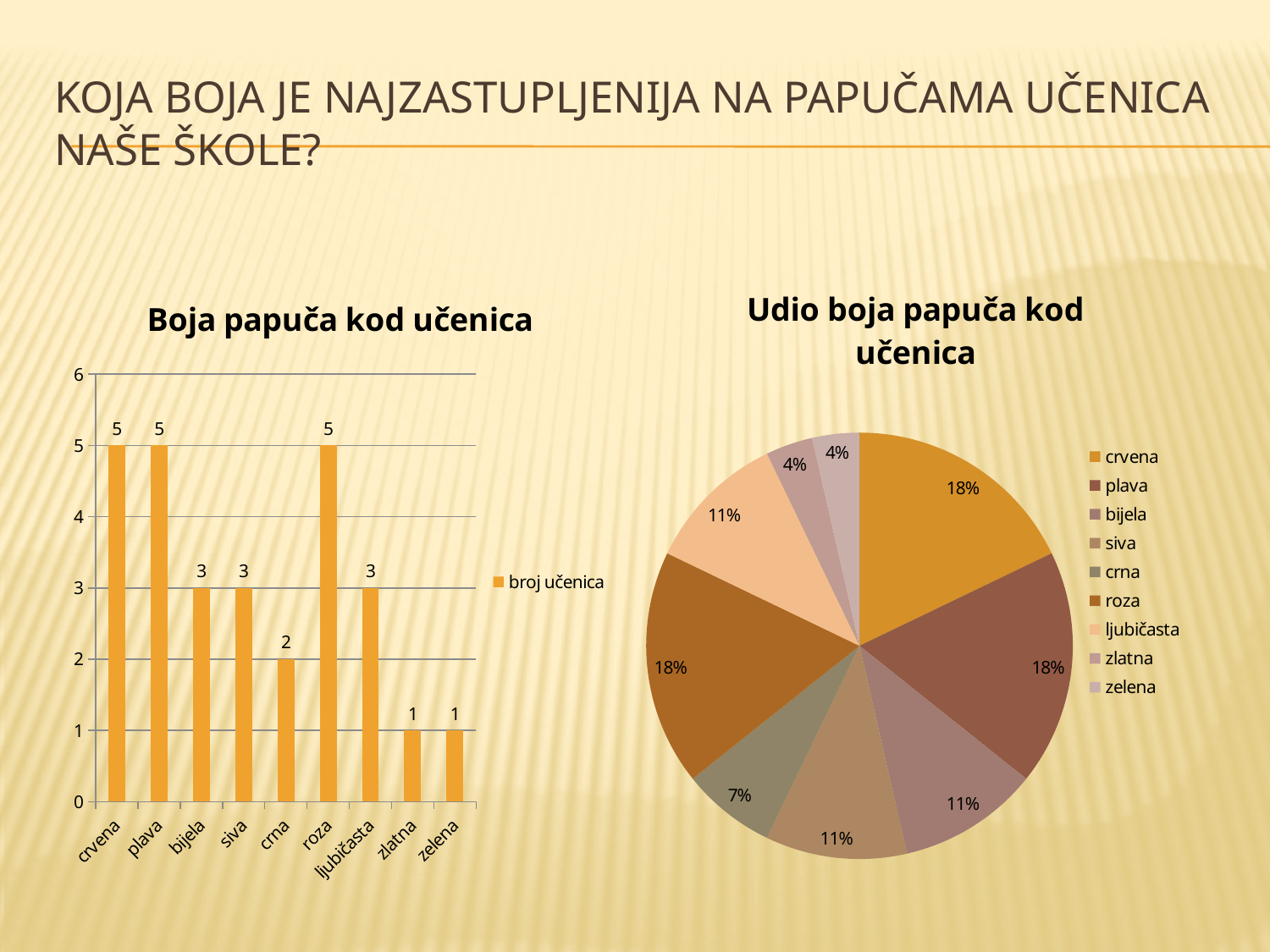
In the chart titled "Udio boja papuča kod učenica", what share does crna have? 7% In the chart titled "Udio boja papuča kod učenica", how many slices does the pie have? 9 In the chart titled "Boja papuča kod učenica", what kind of chart is it? bar chart In the chart titled "Boja papuča kod učenica", how many categories are shown on the x axis? 9 In the chart titled "Boja papuča kod učenica", what series does the legend list? broj učenica In the chart titled "Boja papuča kod učenica", what is the difference between the values for roza and crna? 3 In the chart titled "Boja papuča kod učenica", what is the value for zlatna? 1 In the chart titled "Boja papuča kod učenica", what is the value for crna? 2 In the chart titled "Boja papuča kod učenica", what is the value for ljubičasta? 3 In the chart titled "Boja papuča kod učenica", which is larger, the value for plava or the value for siva? plava In the chart titled "Udio boja papuča kod učenica", what kind of chart is it? pie chart In the chart titled "Udio boja papuča kod učenica", what share does zelena have? 4%